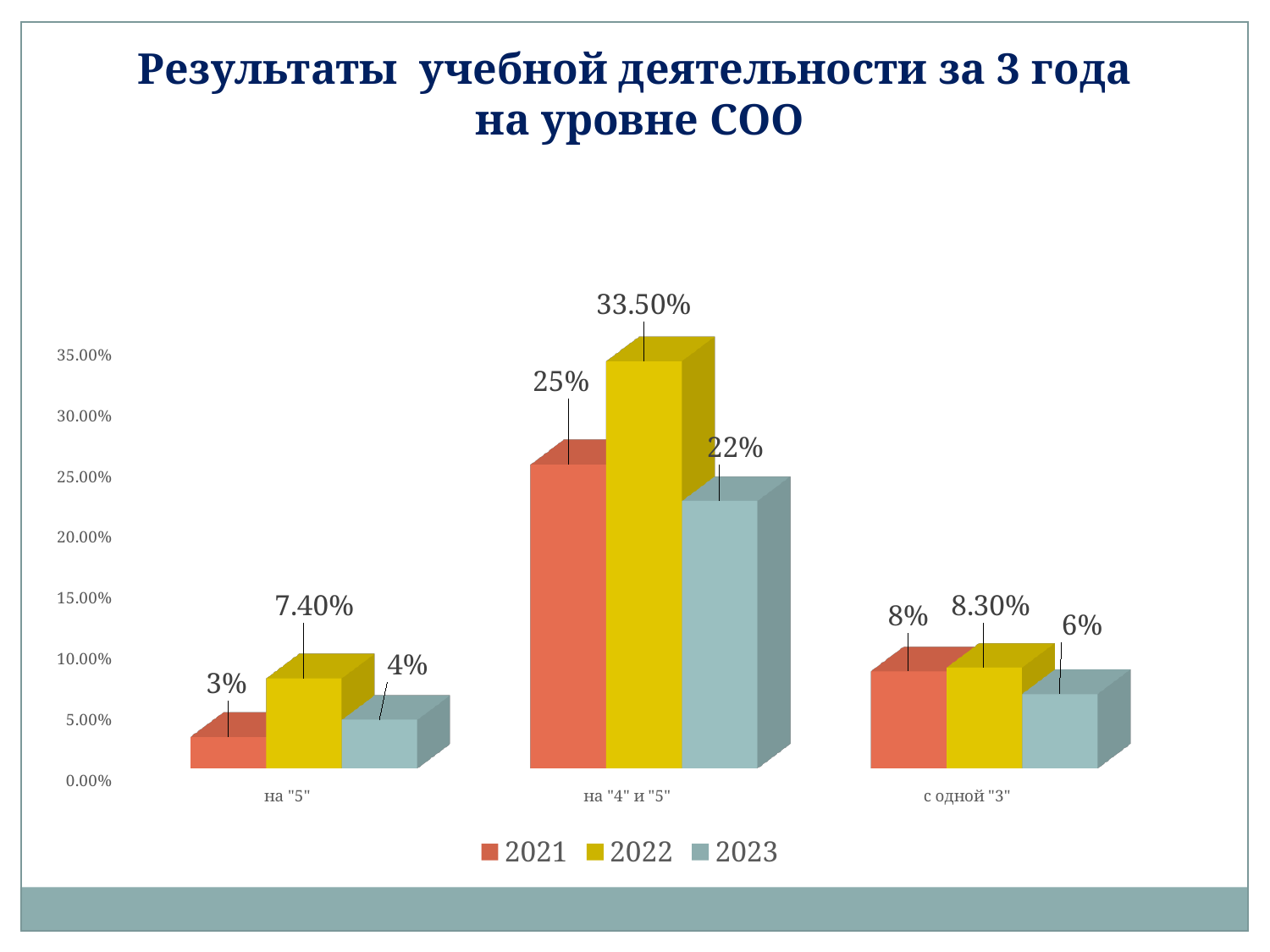
What kind of chart is shown on the slide? Bar chart What is the value for 2022 in the category на "4" и "5"? 33.50% What is the difference between the 2022 and 2021 values in the category на "4" и "5"? 8.50% Which colour represents the 2023 series in the legend? Light blue-grey Which year has the lowest value in the category на "5"? 2021 Which year has the highest value in the category на "4" и "5"? 2022 How many series does the legend list? 3 What is the value for 2023 in the category с одной "3"? 6% Which is larger: the 2021 value or the 2023 value in the category с одной "3"? 2021 What is the value for 2022 in the category с одной "3"? 8.30% How many categories are shown on the x axis? 3 What is the value for 2021 in the category на "5"? 3%